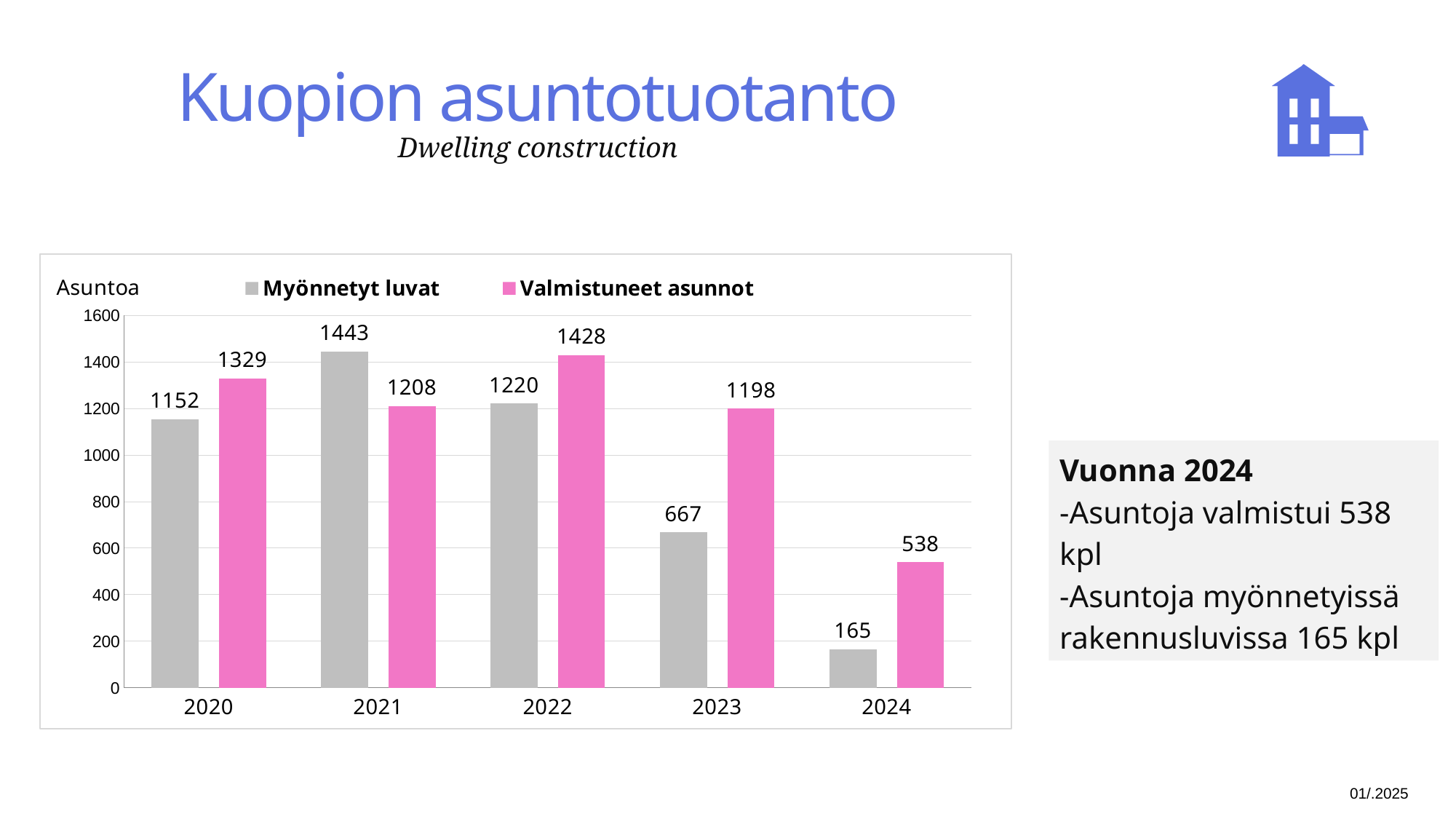
What is the difference between Valmistuneet asunnot and Myönnetyt luvat in 2024? 373 What kind of chart is shown on the slide? bar chart How many years are shown on the x axis? 5 How many series does the legend list? 2 In 2020, which series has the larger value, Myönnetyt luvat or Valmistuneet asunnot? Valmistuneet asunnot Is the value of Myönnetyt luvat for 2023 greater or less than 800? less Which year has the lowest value for Myönnetyt luvat? 2024 What is the difference between Myönnetyt luvat in 2021 and 2022? 223 What is the value of Myönnetyt luvat for 2021? 1443 What is the value of Myönnetyt luvat for 2024? 165 What is the value of Valmistuneet asunnot for 2023? 1198 Which year has the highest value for Valmistuneet asunnot? 2022